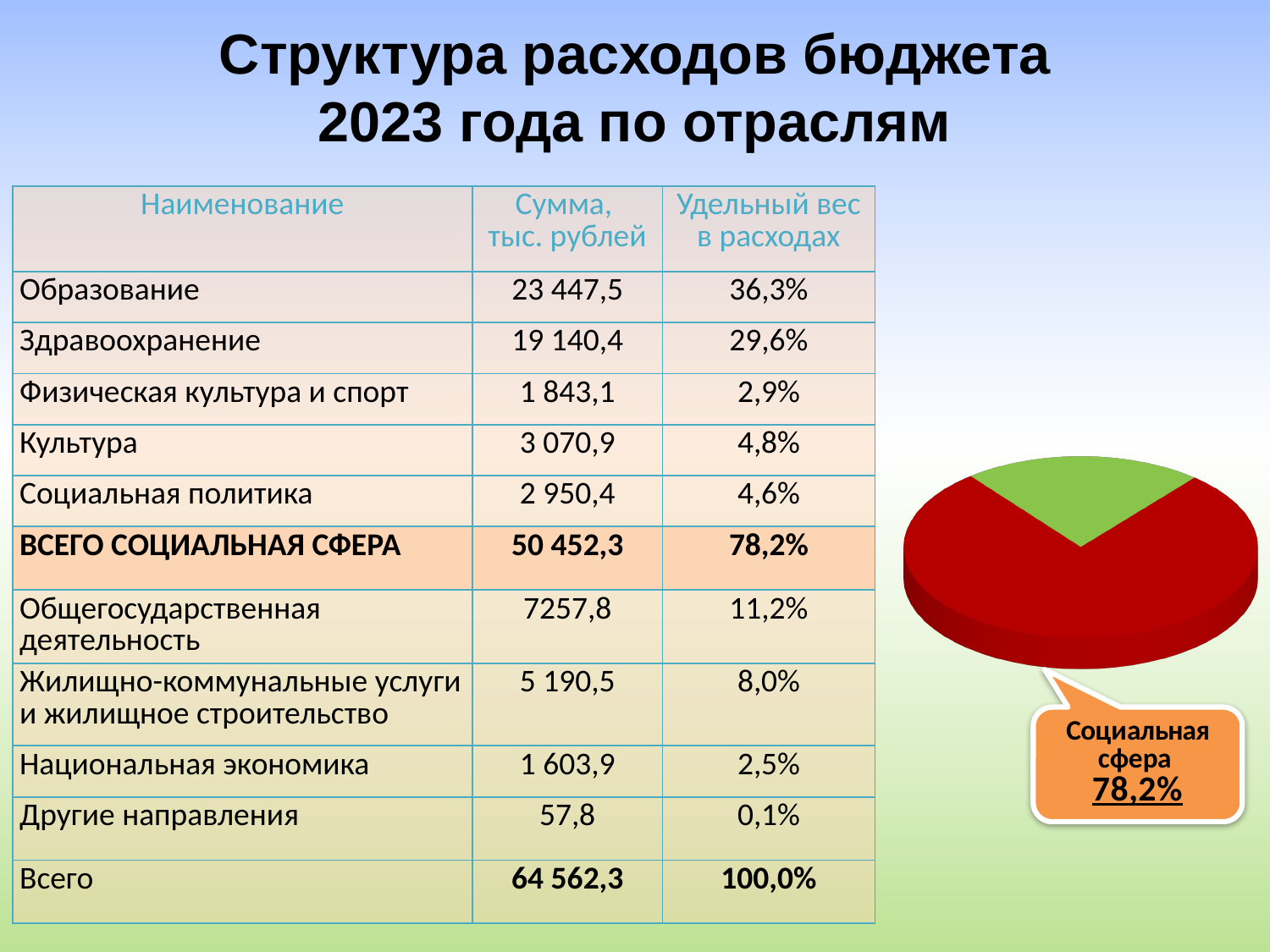
How many slices does the pie chart on the right have? 2 What colour is the Социальная сфера slice in the pie chart? red In the pie chart, what share is labelled for Социальная сфера? 78,2% What label does the callout attached to the pie chart show? Социальная сфера 78,2% Which slice of the pie chart is the largest? Социальная сфера In the pie chart, which slice is larger, the red one or the green one? the red one What kind of chart is shown on the right side of the slide? pie chart